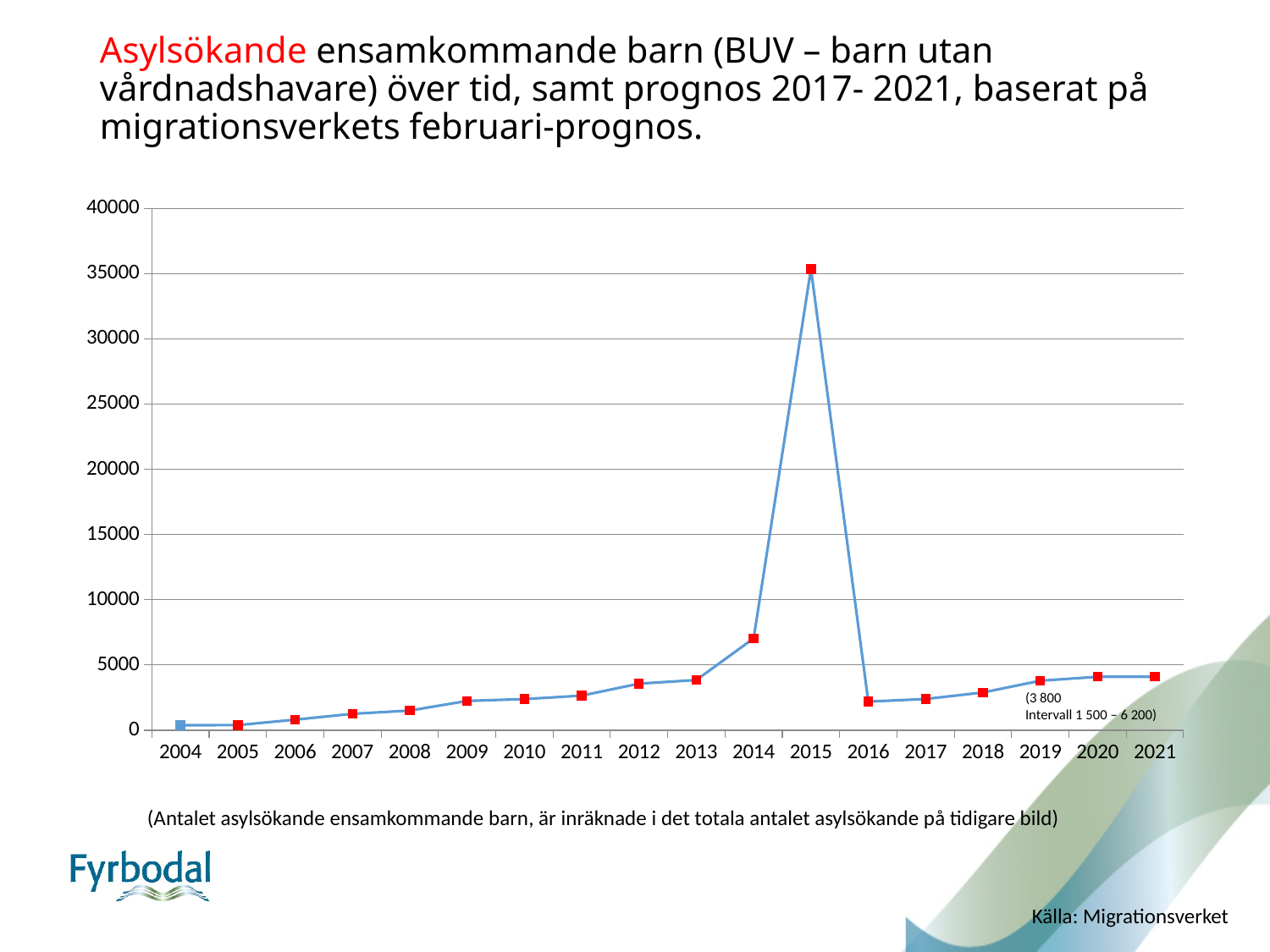
Which year has the highest value in the chart? 2015 How many years are plotted along the x axis of the chart? 18 Is the value for 2014 greater or less than 5000? greater Is the value for 2015 greater or less than 30000? greater What kind of chart is shown on the slide? line chart What source is cited at the bottom right of the slide? Migrationsverket Is the value for 2014 greater or less than 10000? less Which year has the larger value, 2015 or 2016? 2015 Which year has the larger value, 2008 or 2012? 2012 Which year has the larger value, 2013 or 2014? 2014 Do the values generally rise or fall from 2004 to 2014? rise